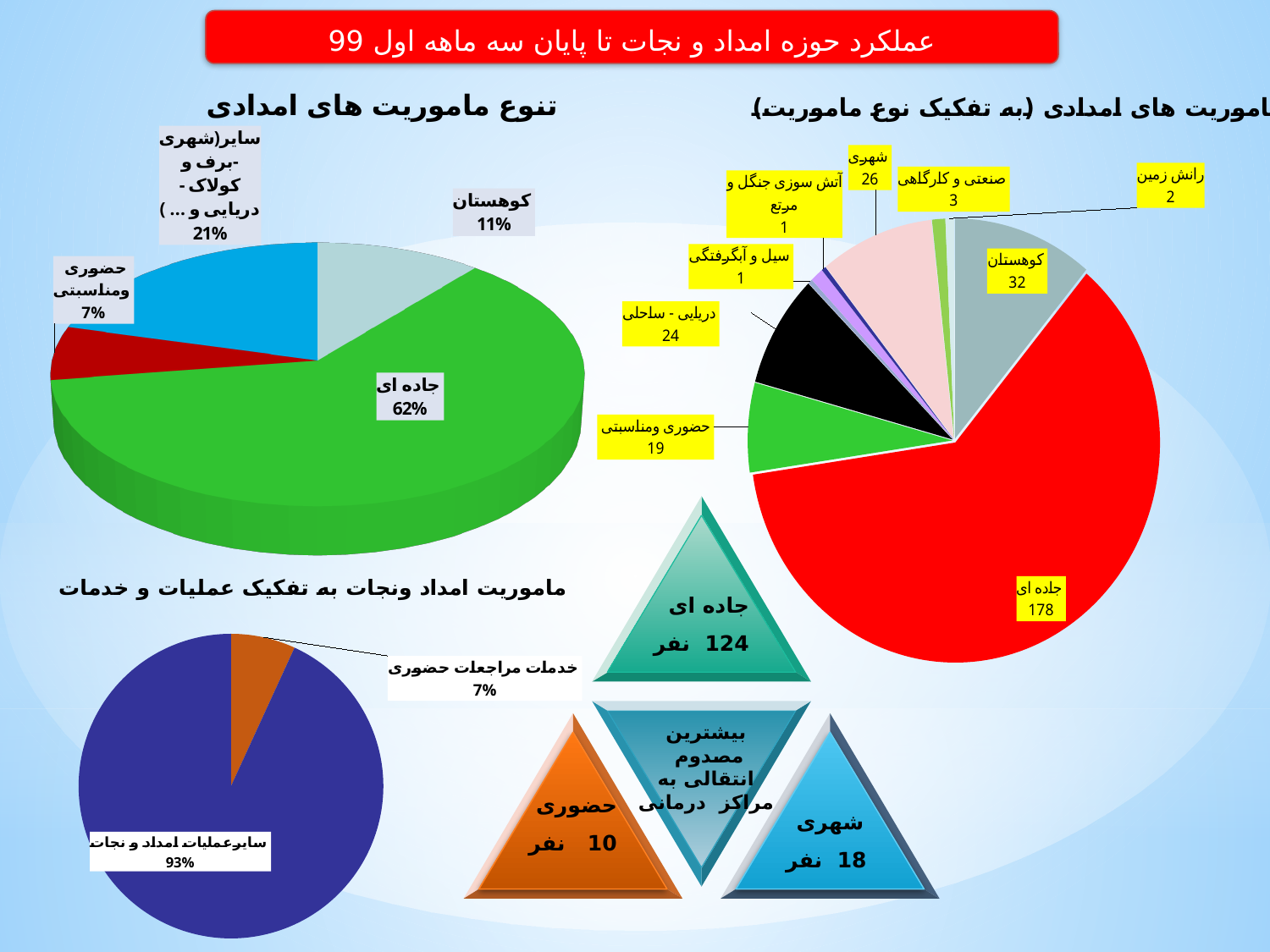
In the bottom-left pie chart titled "ماموریت امداد ونجات به تفکیک عملیات و خدمات", what share does "سایرعملیات امداد و نجات" have? 93% In the top-left pie chart titled "تنوع ماموریت های امدادی", what is the value for "کوهستان"? 11% What type of chart is the bottom-left chart titled "ماموریت امداد ونجات به تفکیک عملیات و خدمات"? pie chart How many categories are labelled in the top-right pie chart titled "ماموریت های امدادی (به تفکیک نوع ماموریت)"? 9 In the top-left pie chart titled "تنوع ماموریت های امدادی", which category has the lowest share? حضوری ومناسبتی In the top-right pie chart titled "ماموریت های امدادی (به تفکیک نوع ماموریت)", which is larger: "حضوری ومناسبتی" or "صنعتی و کارگاهی"? حضوری ومناسبتی In the top-right pie chart titled "ماموریت های امدادی (به تفکیک نوع ماموریت)", what is the value for "جاده ای"? 178 In the top-right pie chart titled "ماموریت های امدادی (به تفکیک نوع ماموریت)", what is the value for "کوهستان"? 32 In the top-left pie chart titled "تنوع ماموریت های امدادی", what share does "جاده ای" have? 62% In the top-right pie chart titled "ماموریت های امدادی (به تفکیک نوع ماموریت)", which category has the highest value? جاده ای How many slices does the top-left pie chart titled "تنوع ماموریت های امدادی" have? 4 In the top-right pie chart titled "ماموریت های امدادی (به تفکیک نوع ماموریت)", what is the difference between the values for "شهری" and "دریایی - ساحلی"? 2